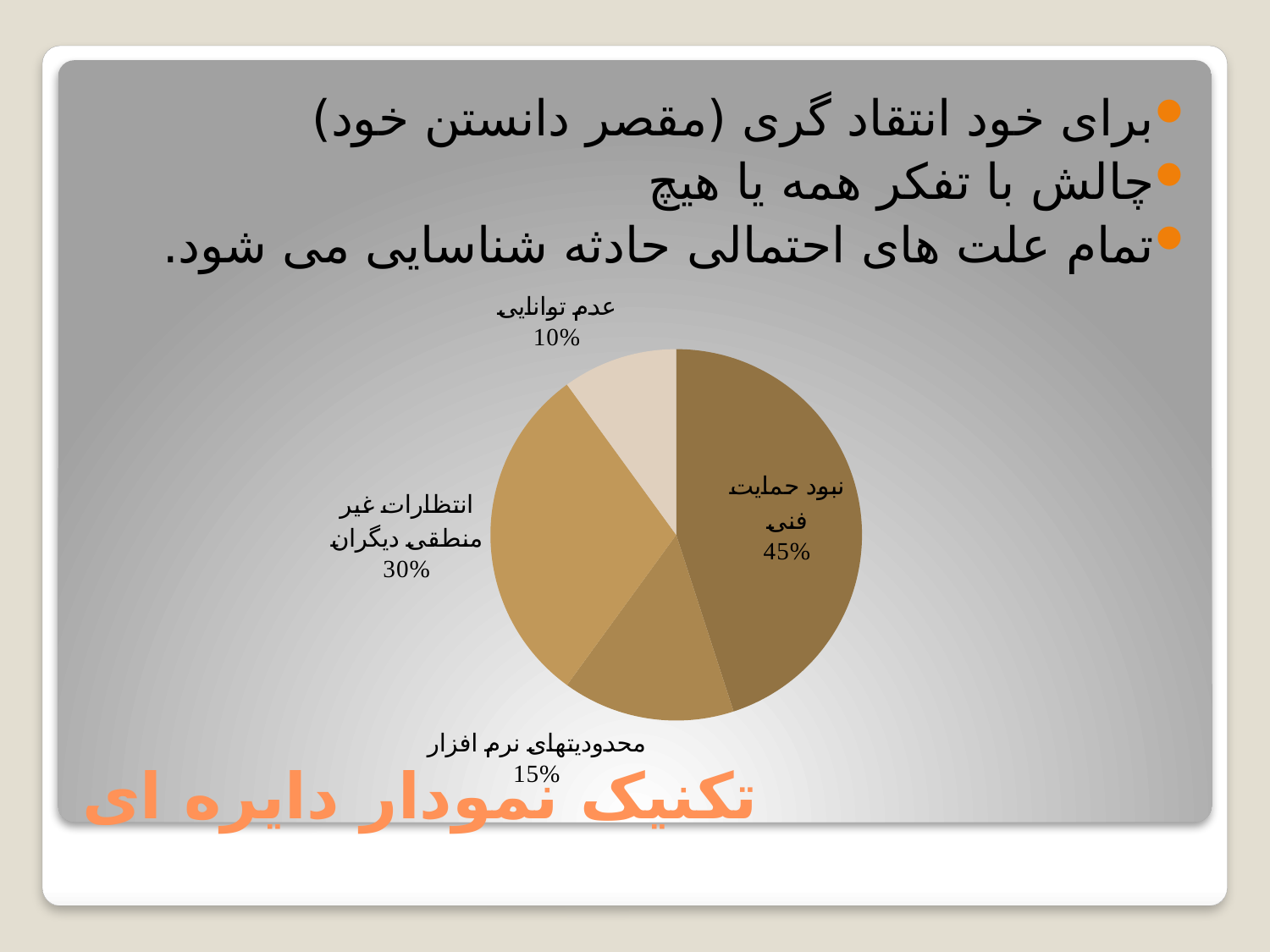
Which is larger: the slice for محدودیتهای نرم افزار or the slice for عدم توانایی? محدودیتهای نرم افزار What is the orange title text at the bottom of the slide? تکنیک نمودار دایره ای What is the combined share of the slices for انتظارات غیر منطقی دیگران and عدم توانایی? 40% What percentage is shown for the slice labelled نبود حمایت فنی? 45% What percentage is shown for the slice labelled انتظارات غیر منطقی دیگران? 30% How many slices does the pie chart have? 4 Which slice of the pie chart is the smallest? عدم توانایی Which slice of the pie chart is the largest? نبود حمایت فنی What percentage is shown for the slice labelled عدم توانایی? 10% What kind of chart is shown on the slide? Pie chart What is the difference in percentage points between نبود حمایت فنی and انتظارات غیر منطقی دیگران? 15 What percentage is shown for the slice labelled محدودیتهای نرم افزار? 15%